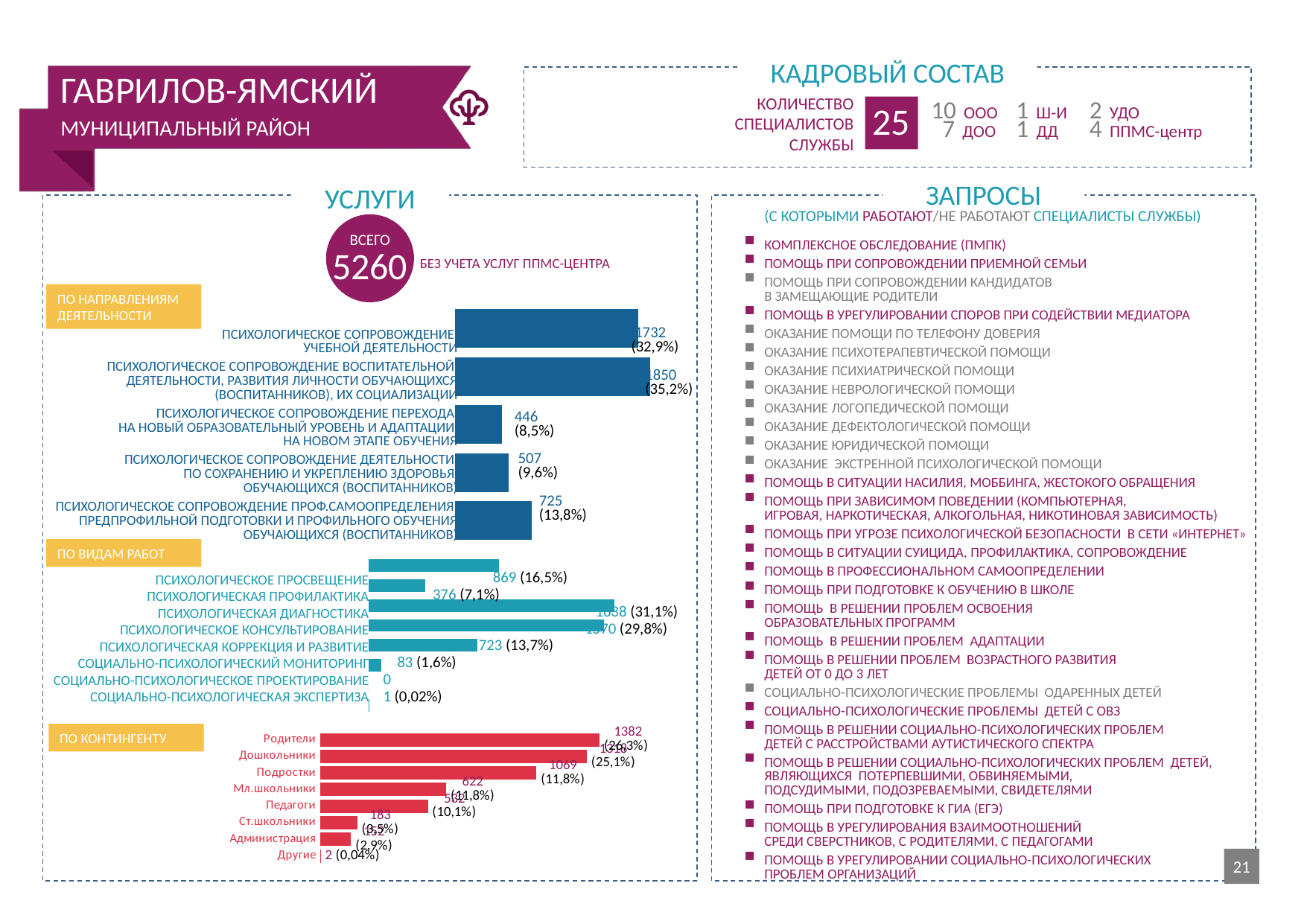
How many categories are shown in the 'По направлениям деятельности' chart? 5 In the 'По контингенту' chart, what value is shown for 'Родители'? 1382 In the 'По направлениям деятельности' chart, which category has the highest value? Психологическое сопровождение воспитательной деятельности, развития личности обучающихся (воспитанников), их социализации What type of chart is the 'По контингенту' chart? Bar chart In the 'По видам работ' chart, what value is shown for 'Социально-психологический мониторинг'? 83 (1,6%) In the 'По направлениям деятельности' chart, what is the difference between the values for 'Психологическое сопровождение проф.самоопределения...' (725) and 'Психологическое сопровождение деятельности по сохранению и укреплению здоровья...' (507)? 218 In the 'По направлениям деятельности' chart, which category has the lowest value? Психологическое сопровождение перехода на новый образовательный уровень и адаптации на новом этапе обучения In the 'По видам работ' chart, which category has the highest value? Психологическая диагностика In the 'По видам работ' chart, what value is shown for 'Психологическое просвещение'? 869 (16,5%) In the 'По видам работ' chart, which is larger: 'Психологическая коррекция и развитие' or 'Психологическая профилактика'? Психологическая коррекция и развитие In the 'По контингенту' chart, what value is shown for 'Ст.школьники'? 183 (3,5%) In the 'По направлениям деятельности' chart, what value is shown for 'Психологическое сопровождение учебной деятельности'? 1732 (32,9%)